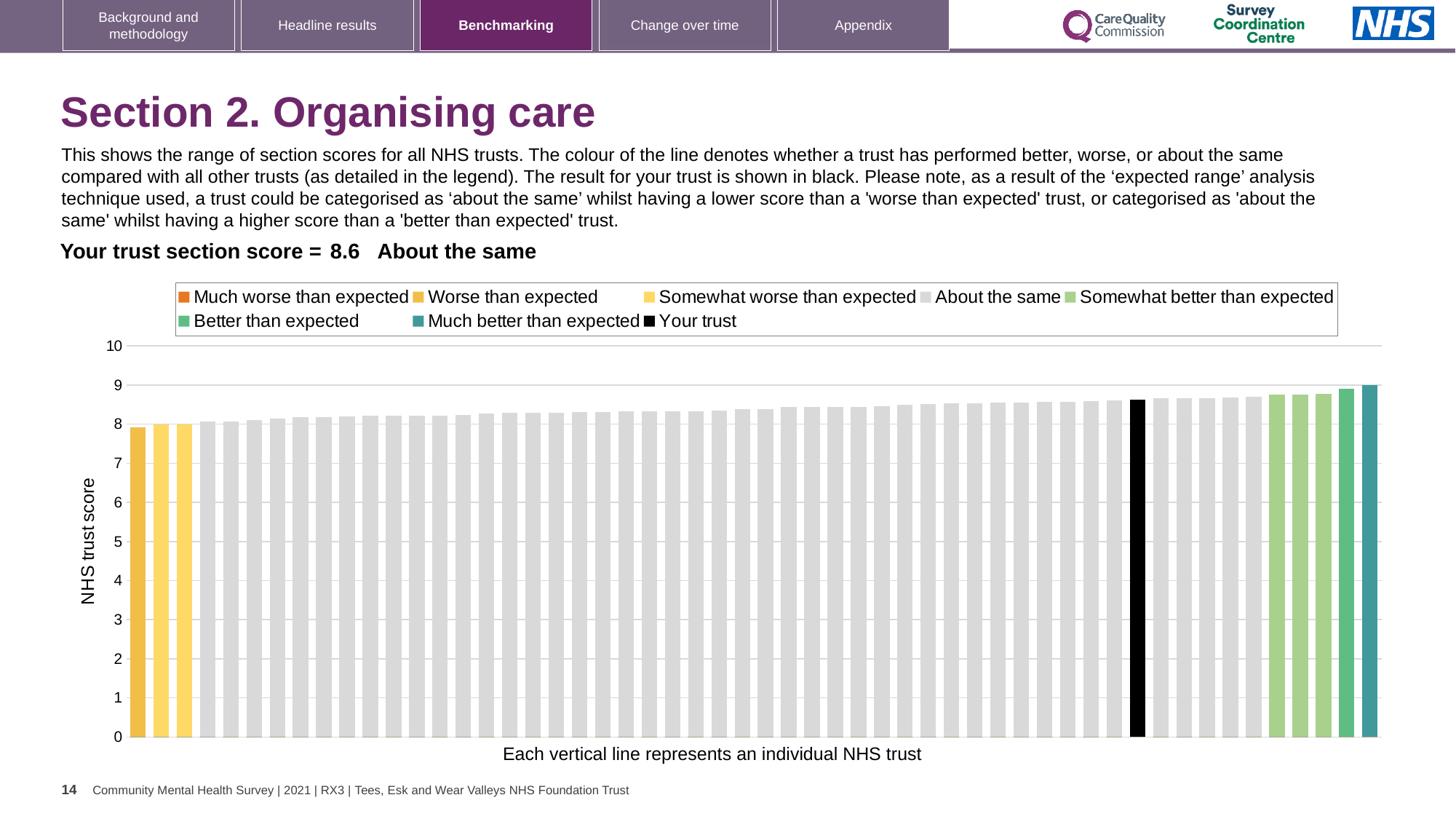
Which legend category does the highest-scoring trust (the rightmost bar) belong to? Much better than expected What kind of chart is shown on the slide? bar chart Is the value for the highest bar greater or less than 10? less What is the title of the vertical axis? NHS trust score Do the bar values rise or fall from left to right along the x axis? rise Which legend category does the lowest-scoring trust (the leftmost bar) belong to? Worse than expected Is the value for your trust (the black bar) greater or less than 8? greater Which performance category is your trust placed in for this section? About the same Is the value for the highest bar greater or less than 8? greater How many entries does the chart legend list? 8 What is the section score for your trust shown on the slide? 8.6 What colour is used for the bar representing your trust? black